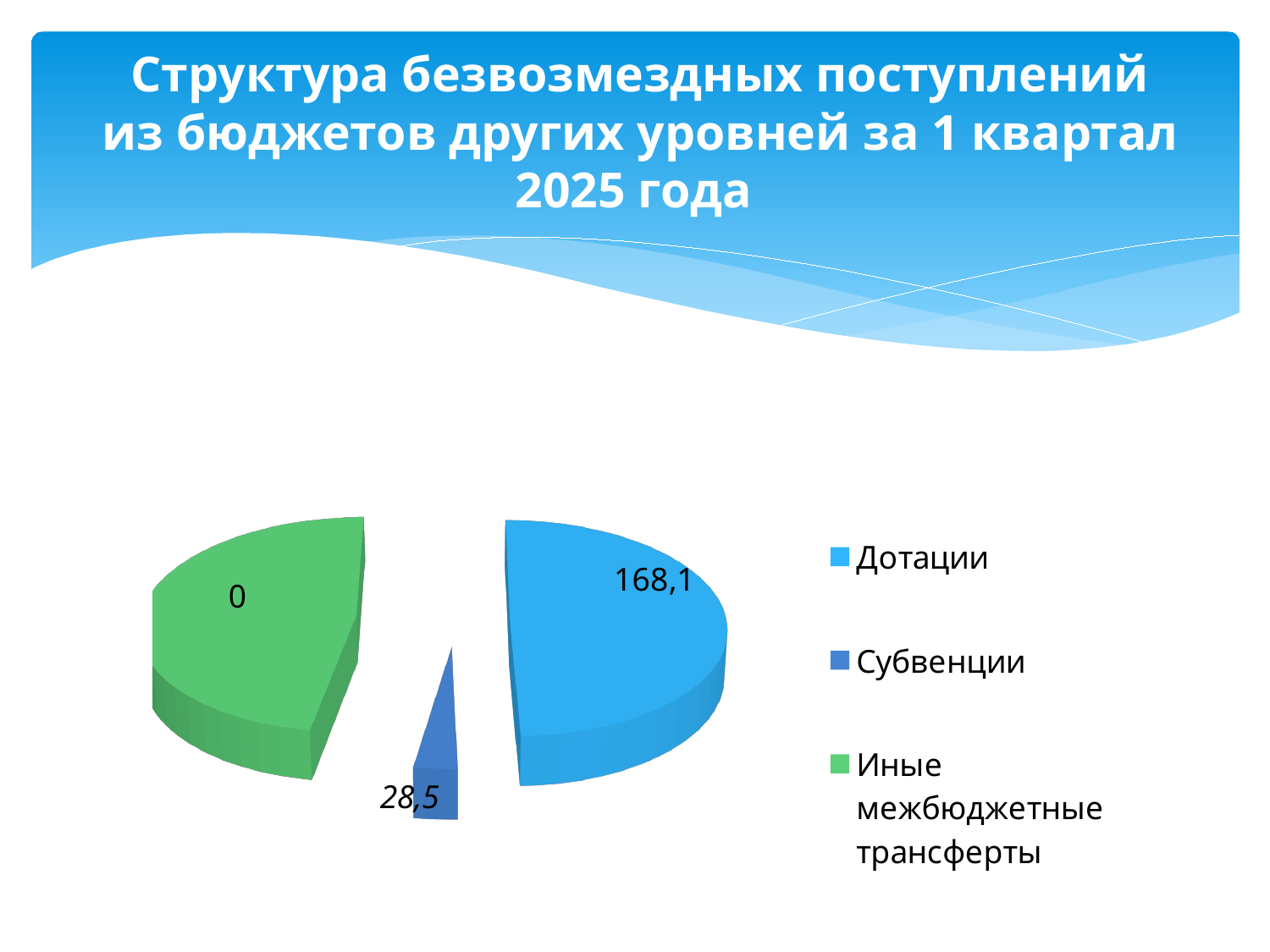
What is the title of the chart on the slide? Структура безвозмездных поступлений из бюджетов других уровней за 1 квартал 2025 года What is the value shown for Иные межбюджетные трансферты? 0 What is the value shown for Субвенции? 28,5 How many categories does the legend list? 3 Which category has the highest value according to the data labels? Дотации What is the sum of all the values shown in the data labels? 196,6 What type of chart is shown on the slide? Pie chart What colour is the slice for Иные межбюджетные трансферты? Green Which category has the lowest value according to the data labels? Иные межбюджетные трансферты Which has the larger value, Дотации or Субвенции? Дотации What is the difference between the values for Дотации and Субвенции? 139,6 What is the value shown for Дотации? 168,1